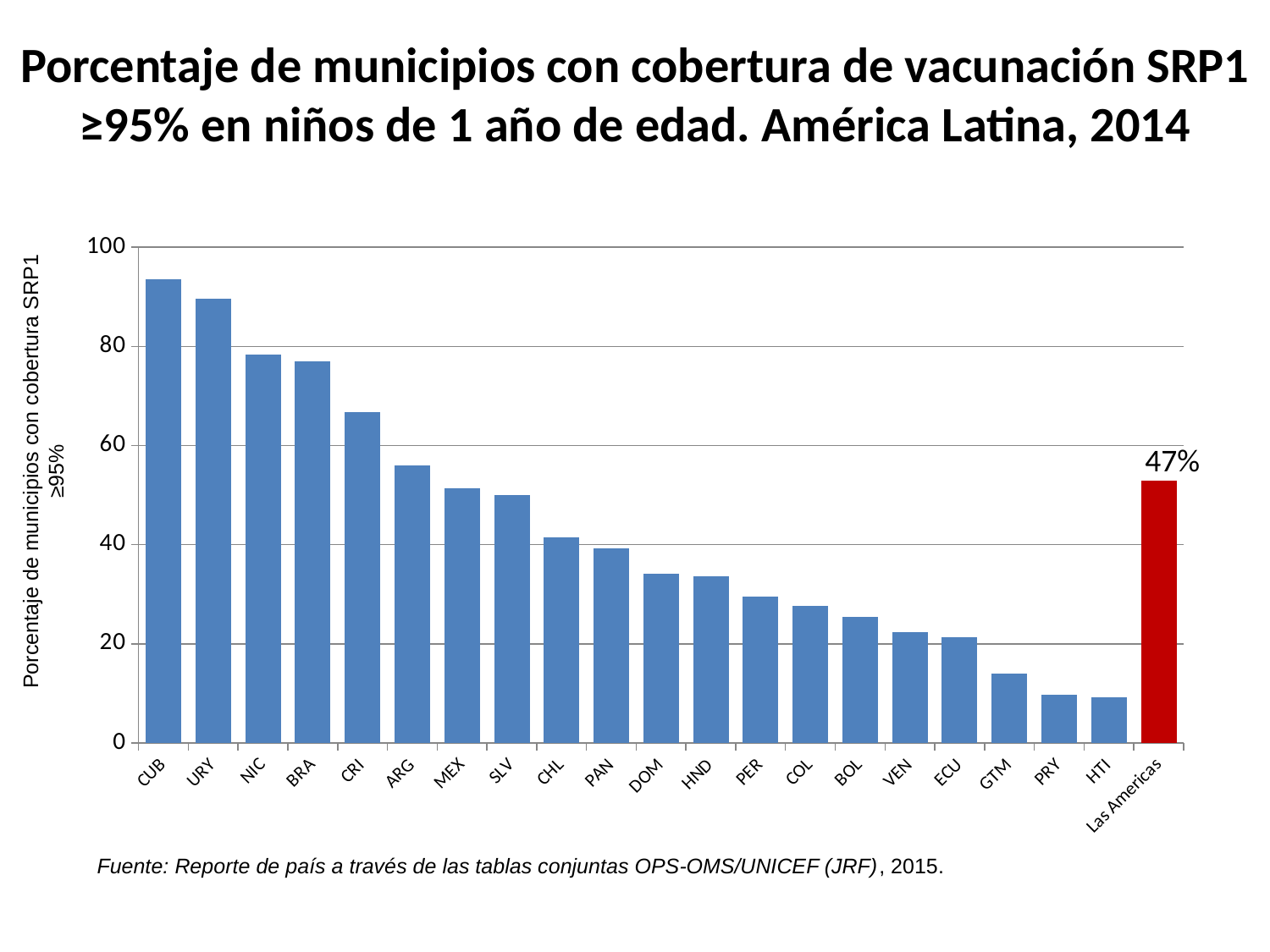
How many bars are shown in the chart? 21 What colour is the Las Americas bar? Red Is the value for CUB greater or less than 80? greater Is the value for CRI greater or less than 60? greater What value is labelled on the Las Americas bar? 47% What kind of chart is shown on the slide? Bar chart Which is larger, the value for CRI or the value for ARG? CRI Which is larger, the value for CUB or the value for URY? CUB Is the value for GTM greater or less than 20? less Which country has the highest percentage of municipalities with SRP1 coverage ≥95%? CUB Do the country bars rise or fall from left to right across the x axis? Fall